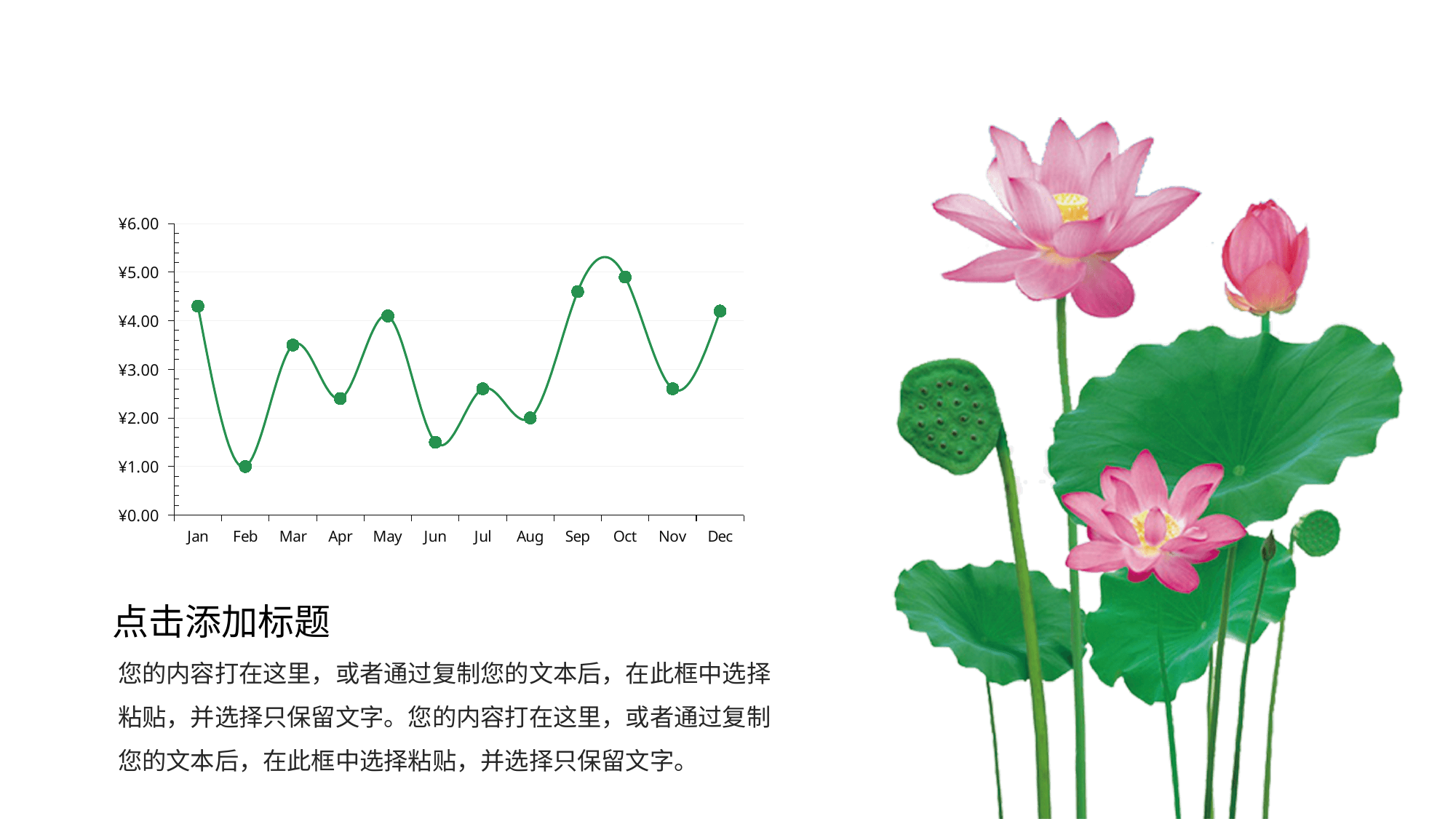
Which month has the lowest value in the chart? Feb Does the value rise or fall from Jan to Feb? fall Which month has the highest value in the chart? Oct Which is larger, the value for Mar or the value for Apr? Mar How many months are plotted on the x axis of the chart? 12 Which is larger, the value for Aug or the value for Dec? Dec What is the label of the top tick on the y axis? ¥6.00 Is the value for Sep greater or less than ¥4.00? greater Is the value for Jun greater or less than ¥2.00? less Is the value for Jan greater or less than ¥4.00? greater What kind of chart is shown on the slide? line chart